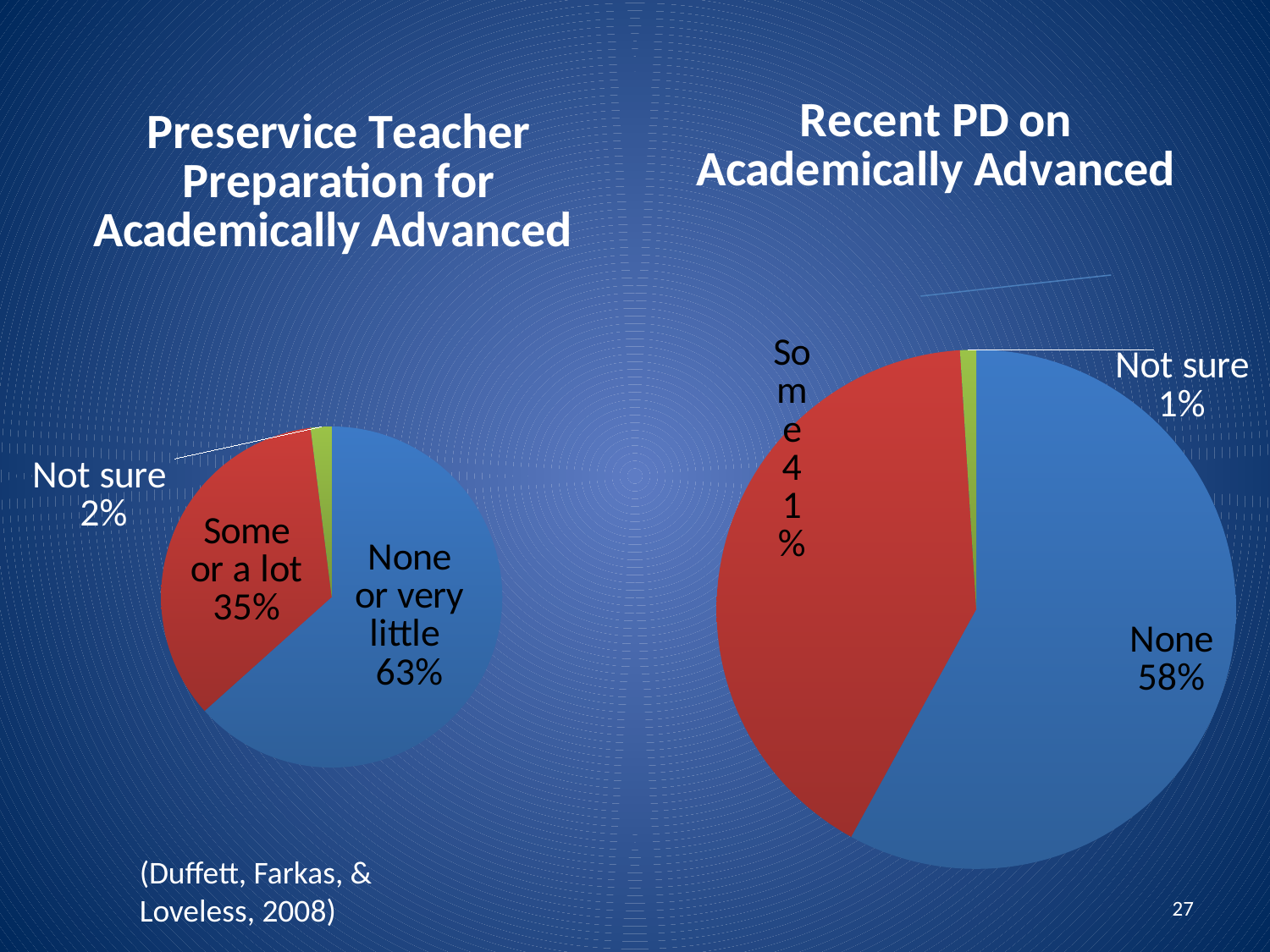
In the 'Preservice Teacher Preparation for Academically Advanced' chart, what share is labelled 'Some or a lot'? 35% In the 'Recent PD on Academically Advanced' chart, what share is labelled 'Not sure'? 1% In the 'Preservice Teacher Preparation for Academically Advanced' chart, which category has the largest slice? None or very little In the 'Recent PD on Academically Advanced' chart, what share is labelled 'Some'? 41% In the 'Preservice Teacher Preparation for Academically Advanced' chart, what share is labelled 'None or very little'? 63% In the 'Recent PD on Academically Advanced' chart, which category has the smallest slice? Not sure In the 'Recent PD on Academically Advanced' chart, what share is labelled 'None'? 58% In the 'Preservice Teacher Preparation for Academically Advanced' chart, what share is labelled 'Not sure'? 2% In the 'Recent PD on Academically Advanced' chart, which is larger, 'None' or 'Some'? None How many slices does the 'Recent PD on Academically Advanced' chart have? 3 In the 'Preservice Teacher Preparation for Academically Advanced' chart, what is the difference between the 'None or very little' and 'Some or a lot' shares? 28% What type of chart is the 'Preservice Teacher Preparation for Academically Advanced' chart? Pie chart